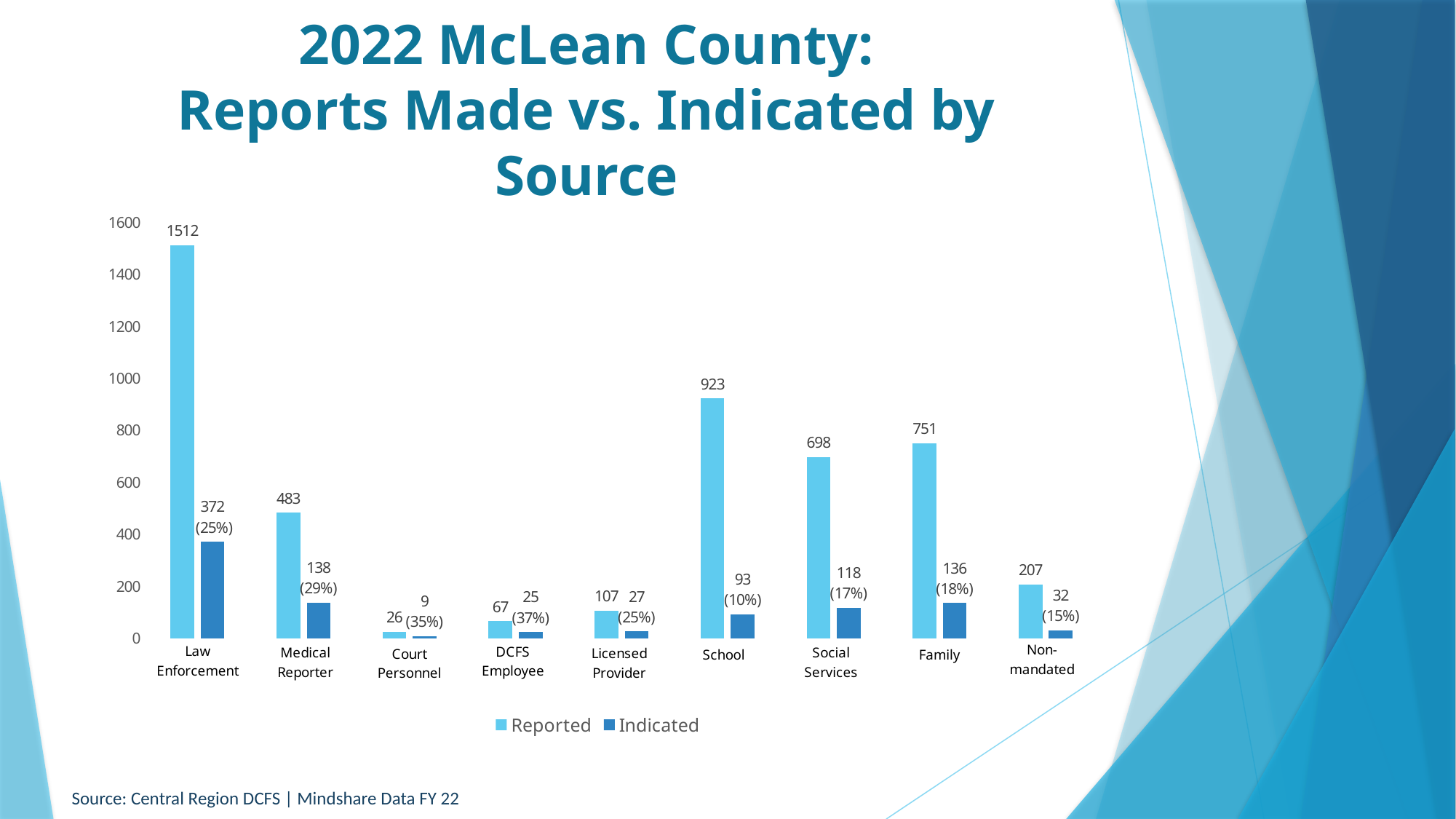
What percentage of Medical Reporter reports were indicated? 29% Which has more reported cases, School or Social Services? School Which source has the highest number of reported cases? Law Enforcement What is the total of reported and indicated cases for Non-mandated? 239 How many reports from School were indicated? 93 Which source has the lowest number of indicated reports? Court Personnel What is the data source cited at the bottom of the slide? Central Region DCFS | Mindshare Data FY 22 What is the difference between reported and indicated cases for Family? 615 How many source categories are shown on the x axis? 9 What kind of chart is shown on the slide? Bar chart How many reports were made by Law Enforcement? 1512 How many series does the legend list? 2